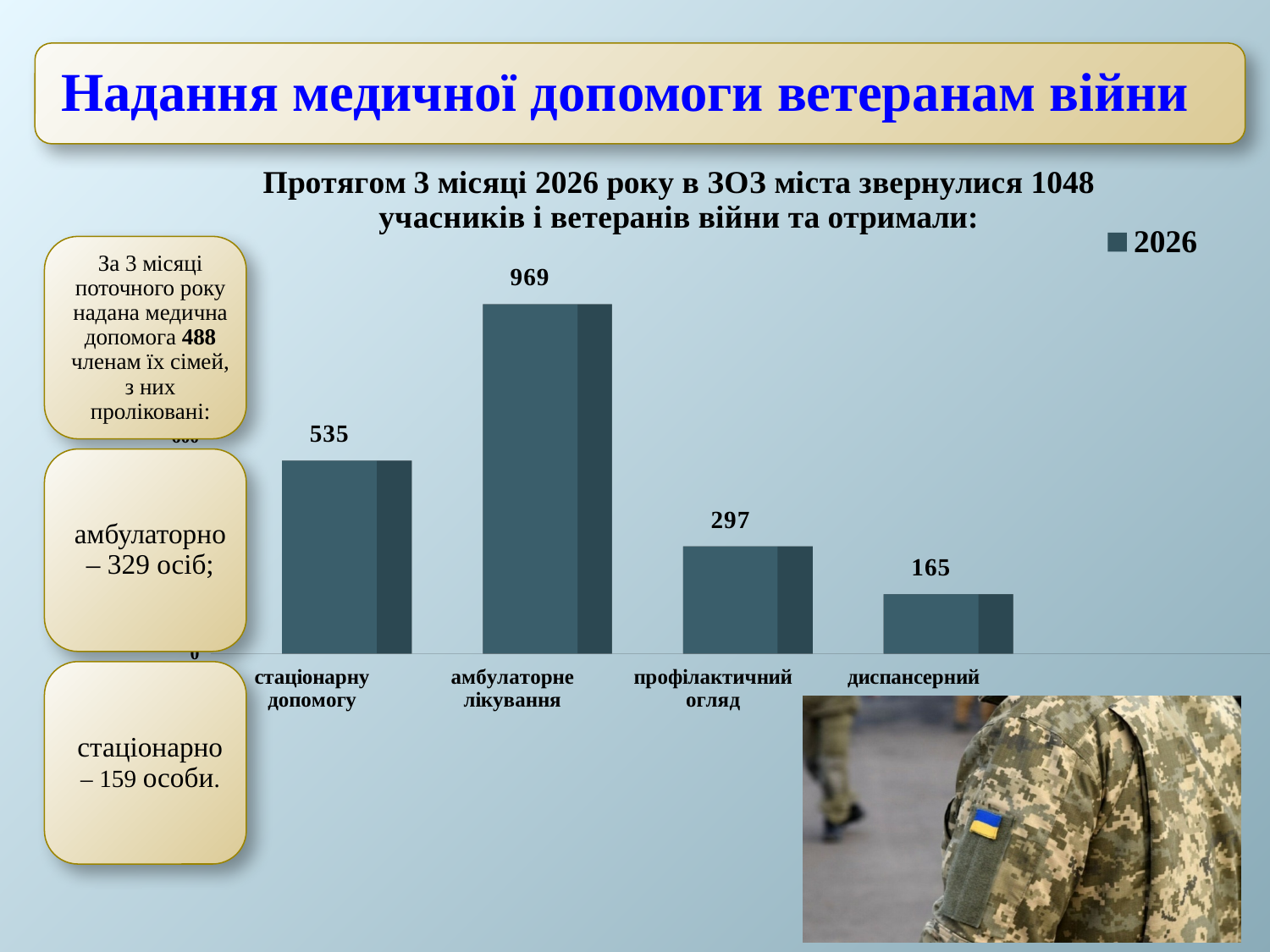
What value is shown for "стаціонарну допомогу"? 535 What value is shown for "амбулаторне лікування"? 969 How many series does the legend list? 1 Which category has the highest value? амбулаторне лікування Which category has the lowest value? диспансерний What kind of chart is shown on the slide? bar chart What value is shown for "диспансерний"? 165 How many categories are shown on the chart? 4 What is the difference between the values for "профілактичний огляд" and "диспансерний"? 132 What is the difference between the values for "амбулаторне лікування" and "стаціонарну допомогу"? 434 What value is shown for "профілактичний огляд"? 297 Which is larger: the value for "стаціонарну допомогу" or the value for "профілактичний огляд"? стаціонарну допомогу